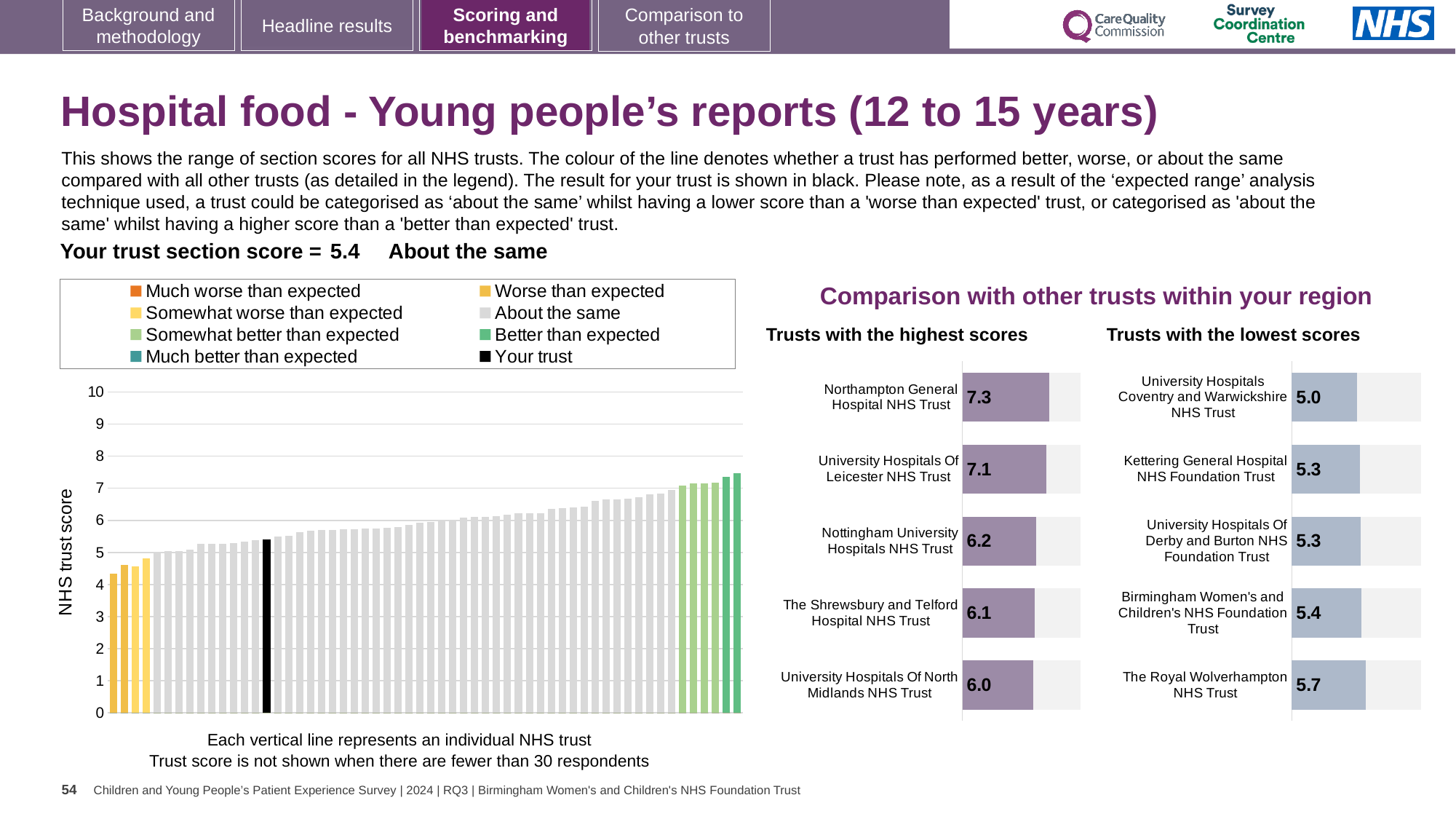
In the main NHS trust score chart, do the bar values rise or fall from left to right? Rise In the 'Trusts with the lowest scores' chart, what is the score for University Hospitals Coventry and Warwickshire NHS Trust? 5.0 In the 'Trusts with the highest scores' chart, what is the difference between the scores of Northampton General Hospital NHS Trust and University Hospitals Of Leicester NHS Trust? 0.2 In the 'Trusts with the highest scores' chart, which trust has the highest score? Northampton General Hospital NHS Trust In the 'Trusts with the highest scores' chart, which has the larger score: Nottingham University Hospitals NHS Trust or The Shrewsbury and Telford Hospital NHS Trust? Nottingham University Hospitals NHS Trust In the 'Trusts with the lowest scores' chart, what is the difference between the scores of The Royal Wolverhampton NHS Trust and University Hospitals Coventry and Warwickshire NHS Trust? 0.7 In the 'Trusts with the lowest scores' chart, what is the score for The Royal Wolverhampton NHS Trust? 5.7 How many trusts are shown in the 'Trusts with the highest scores' chart? 5 How many entries does the legend of the main NHS trust score chart list? 8 What kind of chart is the main chart on the left showing NHS trust scores? Bar chart In the 'Trusts with the highest scores' chart, what is the score for Northampton General Hospital NHS Trust? 7.3 In the 'Trusts with the lowest scores' chart, which trust has the lowest score? University Hospitals Coventry and Warwickshire NHS Trust